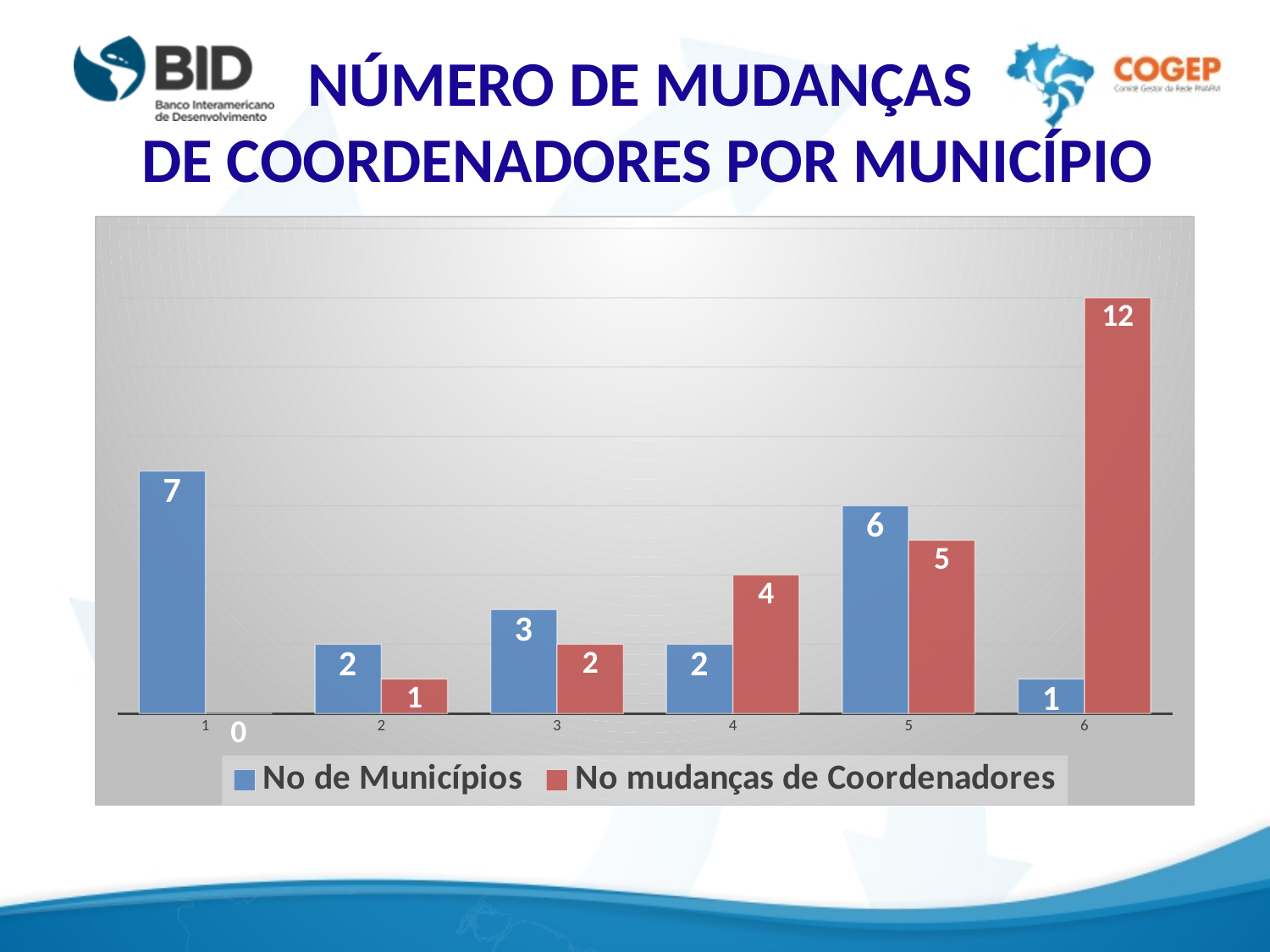
What is the value of 'No mudanças de Coordenadores' for category 6? 12 Which category has the lowest value for 'No mudanças de Coordenadores'? 1 Which colour represents 'No mudanças de Coordenadores' in the legend? red Which category has the highest value for 'No de Municípios'? 1 What kind of chart is shown on the slide? bar chart What is the value of 'No de Municípios' for category 4? 2 What is the difference between 'No mudanças de Coordenadores' and 'No de Municípios' for category 6? 11 What is the value of 'No mudanças de Coordenadores' for category 1? 0 How many categories are shown on the x axis? 6 What is the value of 'No de Municípios' for category 1? 7 For category 5, which series has the larger value, 'No de Municípios' or 'No mudanças de Coordenadores'? No de Municípios How many series does the legend list? 2